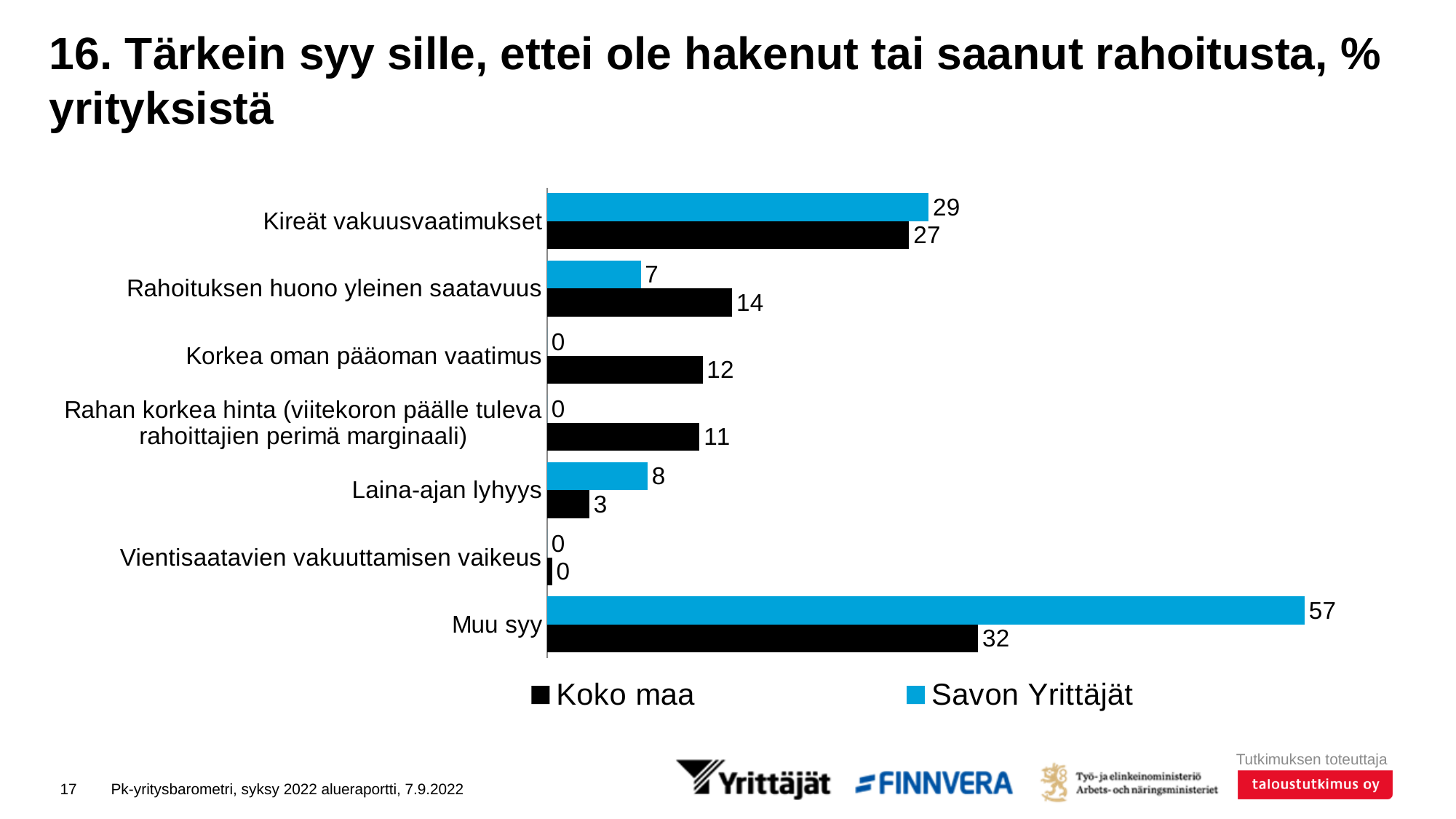
Which category has the lowest value for Koko maa? Vientisaatavien vakuuttamisen vaikeus What is the value for Koko maa for Rahan korkea hinta (viitekoron päälle tuleva rahoittajien perimä marginaali)? 11 What is the value for Koko maa for Korkea oman pääoman vaatimus? 12 Which category has the highest value for Savon Yrittäjät? Muu syy Which colour represents the Savon Yrittäjät series? Blue What is the difference between the Savon Yrittäjät and Koko maa values for Muu syy? 25 What is the value for Koko maa for Rahoituksen huono yleinen saatavuus? 14 How many series does the legend list? 2 What kind of chart is shown on the slide? Bar chart How many categories are shown on the chart? 7 For Laina-ajan lyhyys, which series has the larger value, Koko maa or Savon Yrittäjät? Savon Yrittäjät What is the value for Savon Yrittäjät for Kireät vakuusvaatimukset? 29